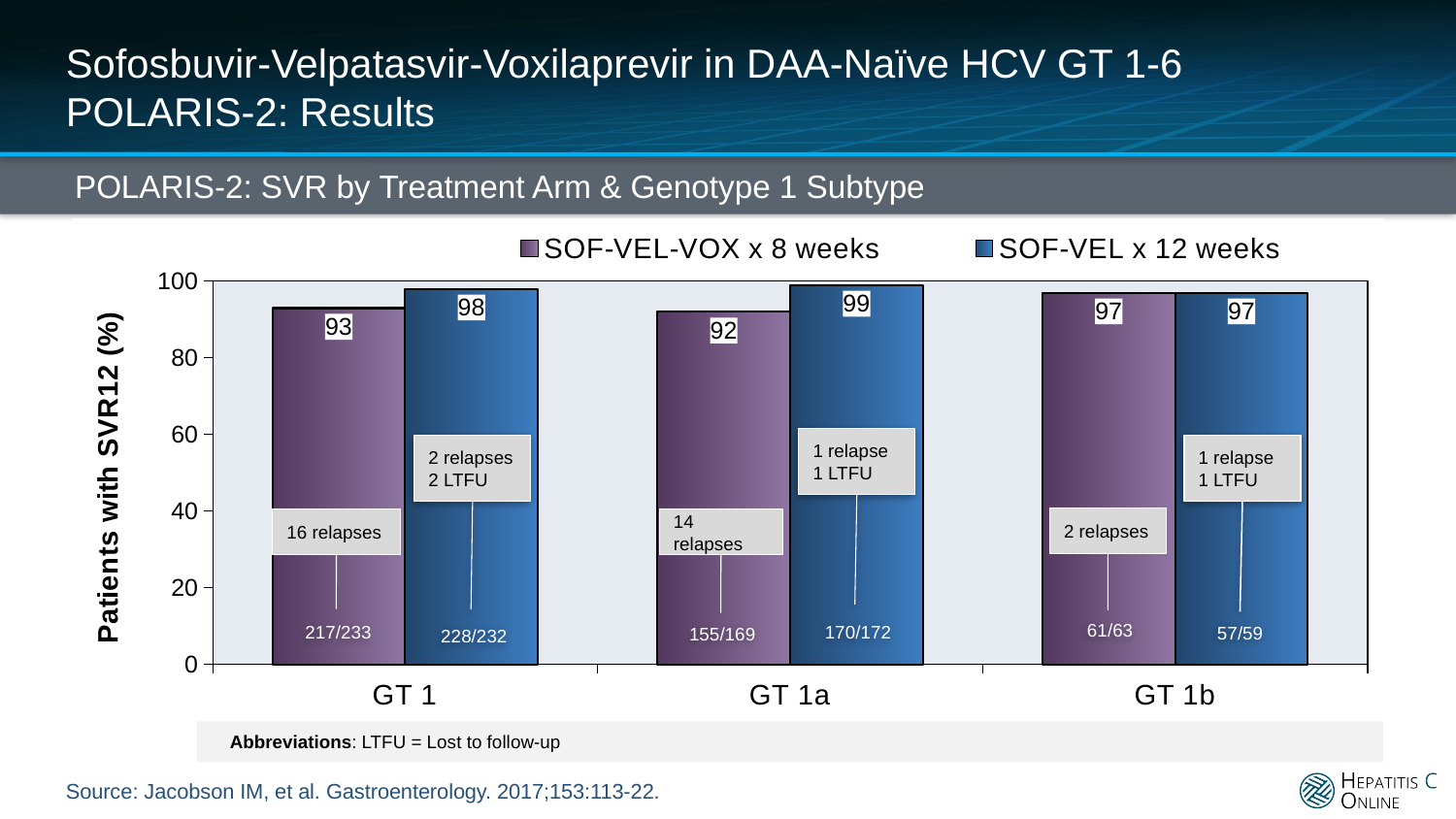
Which treatment arm has the higher SVR12 rate in GT 1, SOF-VEL-VOX x 8 weeks or SOF-VEL x 12 weeks? SOF-VEL x 12 weeks What is the SVR12 rate for SOF-VEL x 12 weeks in GT 1a? 99 What kind of chart is shown on the slide? Bar chart Which genotype subtype has the highest SVR12 rate for SOF-VEL x 12 weeks? GT 1a How many relapses are reported for SOF-VEL-VOX x 8 weeks in GT 1? 16 relapses Which genotype subtype has the lowest SVR12 rate for SOF-VEL-VOX x 8 weeks? GT 1a What is the SVR12 rate for SOF-VEL-VOX x 8 weeks in GT 1b? 97 What is the SVR12 rate for SOF-VEL-VOX x 8 weeks in GT 1? 93 What is the difference in SVR12 rate between SOF-VEL x 12 weeks and SOF-VEL-VOX x 8 weeks in GT 1a? 7 How many series does the legend list? 2 How many genotype subtype categories are shown on the x axis? 3 What is the y-axis label of the chart? Patients with SVR12 (%)